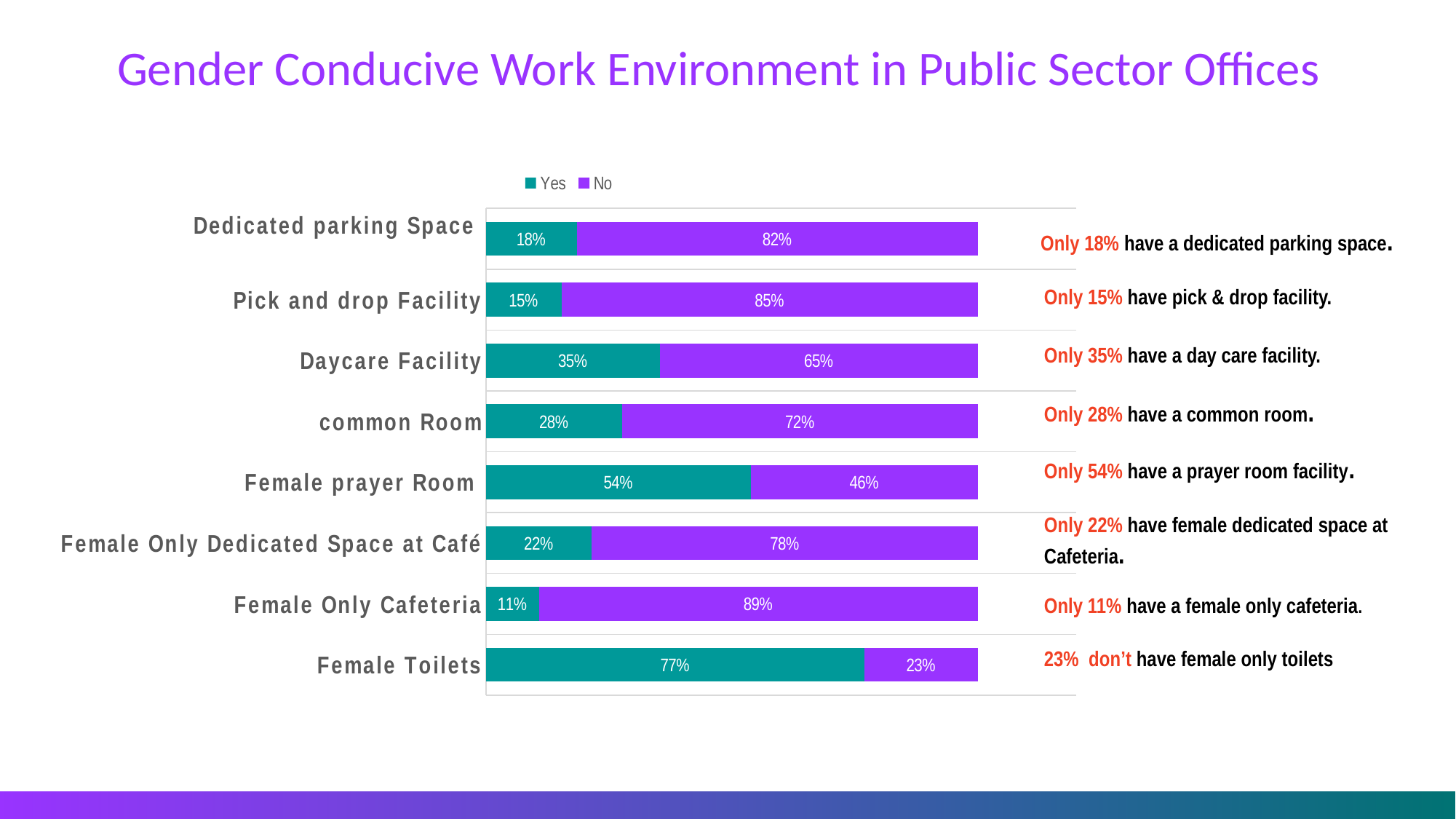
What is the 'Yes' value for Daycare Facility? 35% How many series does the legend list? 2 Which category has the lowest 'Yes' value? Female Only Cafeteria What is the 'Yes' value for Female prayer Room? 54% What is the difference between the 'No' value for Pick and drop Facility and the 'No' value for Daycare Facility? 20% Which is larger: the 'Yes' value for common Room or the 'Yes' value for Female Only Dedicated Space at Café? common Room What is the 'No' value for Female Only Cafeteria? 89% Which colour represents the 'No' series in the chart? Purple Which category has the highest 'Yes' value? Female Toilets What is the total of the 'Yes' and 'No' values for Dedicated parking Space? 100% What kind of chart is shown on the slide? Stacked bar chart How many categories are shown in the chart? 8